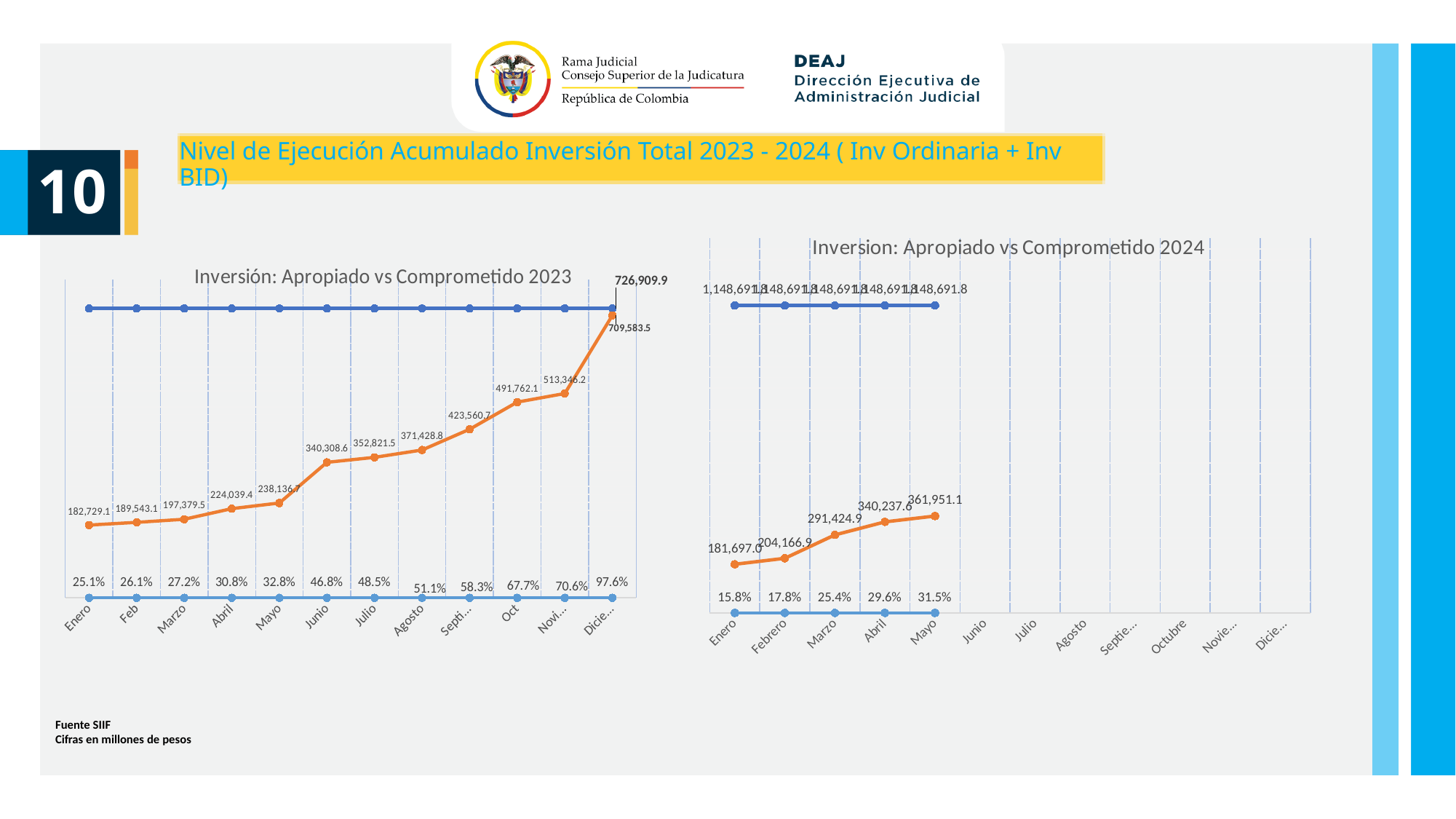
In the 'Inversion: Apropiado vs Comprometido 2024' chart, what percentage is shown for Marzo? 25.4% In the 'Inversión: Apropiado vs Comprometido 2023' chart, what is the committed (orange line) value for Enero? 182,729.1 In the 'Inversión: Apropiado vs Comprometido 2023' chart, which month has the highest orange line value? Diciembre In the 'Inversión: Apropiado vs Comprometido 2023' chart, what is the difference between the Oct value (491,762.1) and the Septiembre value (423,560.7) on the orange line? 68,201.4 In the 'Inversion: Apropiado vs Comprometido 2024' chart, what is the orange line value for Mayo? 361,951.1 What type of chart is the 'Inversion: Apropiado vs Comprometido 2024' chart? line chart In the 'Inversión: Apropiado vs Comprometido 2023' chart, what is the orange line value for Junio? 340,308.6 In the 'Inversion: Apropiado vs Comprometido 2024' chart, what is the value shown on the blue line for Enero? 1,148,691.8 In the 'Inversión: Apropiado vs Comprometido 2023' chart, what percentage is shown for Diciembre? 97.6% In the 'Inversión: Apropiado vs Comprometido 2023' chart, does the orange line rise or fall from Enero to Diciembre? rise In the 'Inversión: Apropiado vs Comprometido 2023' chart, what is the value labelled at the end of the blue line? 726,909.9 In the 'Inversion: Apropiado vs Comprometido 2024' chart, how many months have plotted orange line values? 5